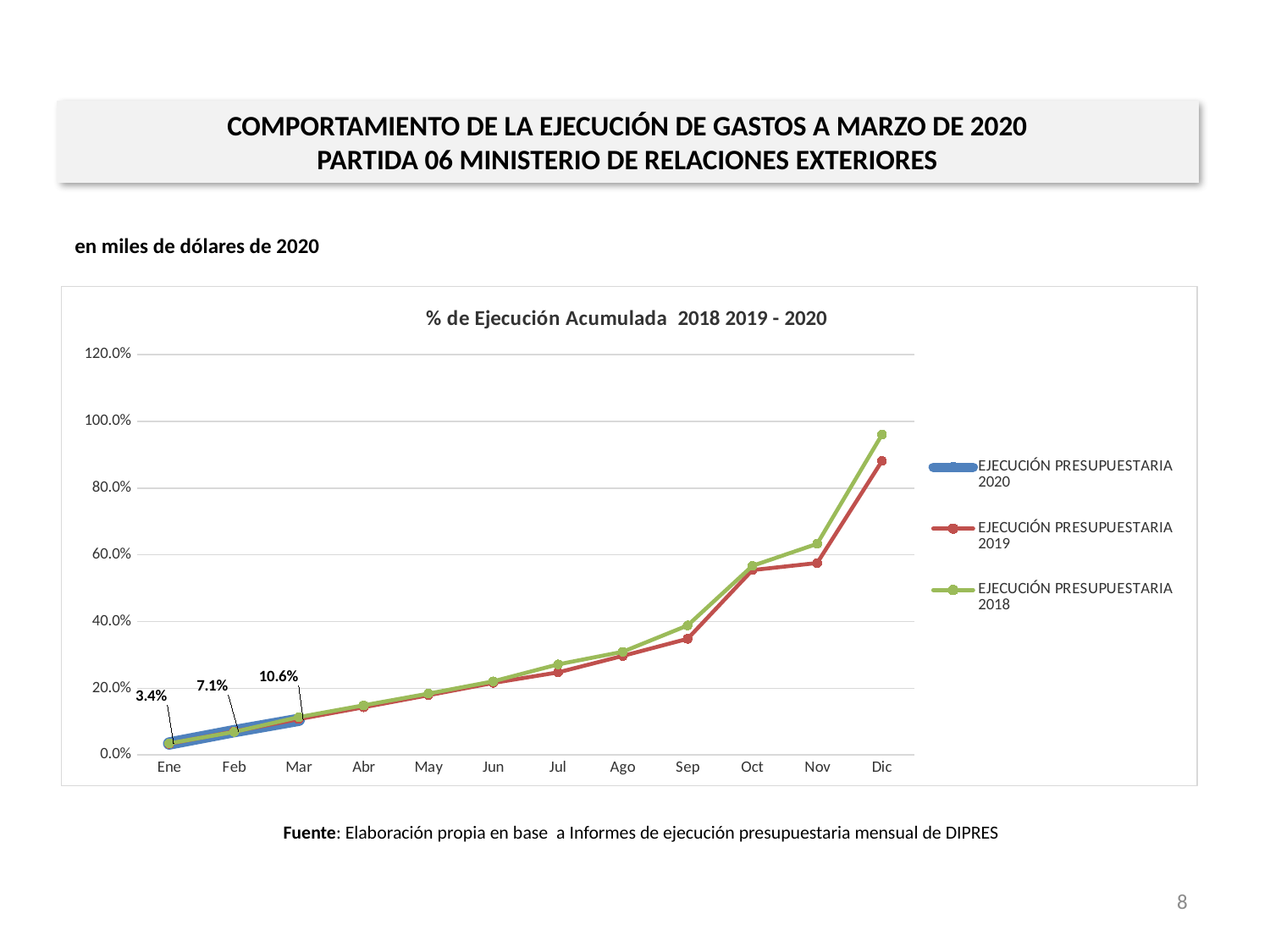
How many series does the legend list? 3 Do the values for EJECUCIÓN PRESUPUESTARIA 2018 rise or fall from Ene to Dic? rise How many months are shown on the x axis? 12 What is the value for EJECUCIÓN PRESUPUESTARIA 2020 in Ene? 3.4% What is the value for EJECUCIÓN PRESUPUESTARIA 2020 in Feb? 7.1% What is the difference between the 2020 values for Mar and Ene? 7.2% Is the value for EJECUCIÓN PRESUPUESTARIA 2018 in Dic greater or less than 80%? greater What kind of chart is shown on the slide? line chart What is the value for EJECUCIÓN PRESUPUESTARIA 2020 in Mar? 10.6% What is the title of the chart? % de Ejecución Acumulada 2018 2019 - 2020 In Dic, which series has the higher value, EJECUCIÓN PRESUPUESTARIA 2018 or EJECUCIÓN PRESUPUESTARIA 2019? EJECUCIÓN PRESUPUESTARIA 2018 Is the value for EJECUCIÓN PRESUPUESTARIA 2019 in Nov greater or less than 60%? less